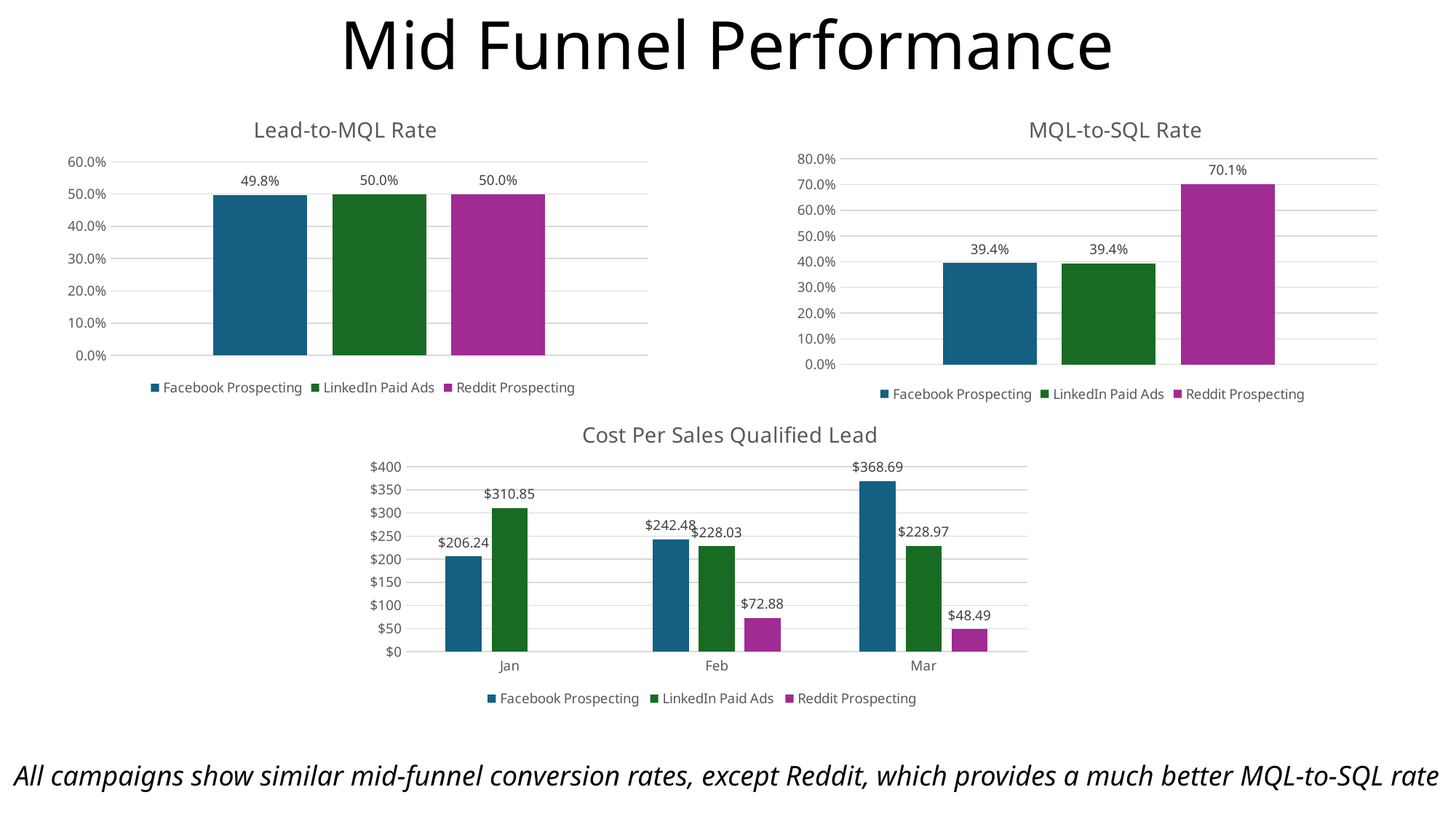
In the Cost Per Sales Qualified Lead chart, does the Facebook Prospecting cost rise or fall from Jan to Mar? rises In the MQL-to-SQL Rate chart, how much higher is Reddit Prospecting than Facebook Prospecting? 30.7 percentage points How many series does the legend of the Cost Per Sales Qualified Lead chart list? 3 In the Cost Per Sales Qualified Lead chart, which is larger in Feb: Facebook Prospecting or LinkedIn Paid Ads? Facebook Prospecting In the Cost Per Sales Qualified Lead chart, what is the difference between Facebook Prospecting in Mar and Facebook Prospecting in Jan? $162.45 In the Cost Per Sales Qualified Lead chart, which bar is the lowest? Reddit Prospecting in Mar In the Cost Per Sales Qualified Lead chart, what is the value for Reddit Prospecting in Mar? $48.49 In the MQL-to-SQL Rate chart, which campaign has the highest rate? Reddit Prospecting In the Cost Per Sales Qualified Lead chart, what is the value for LinkedIn Paid Ads in Jan? $310.85 In the MQL-to-SQL Rate chart, what is the value for Reddit Prospecting? 70.1% In the Lead-to-MQL Rate chart, what is the value for Facebook Prospecting? 49.8% In the Cost Per Sales Qualified Lead chart, which bar is the highest? Facebook Prospecting in Mar